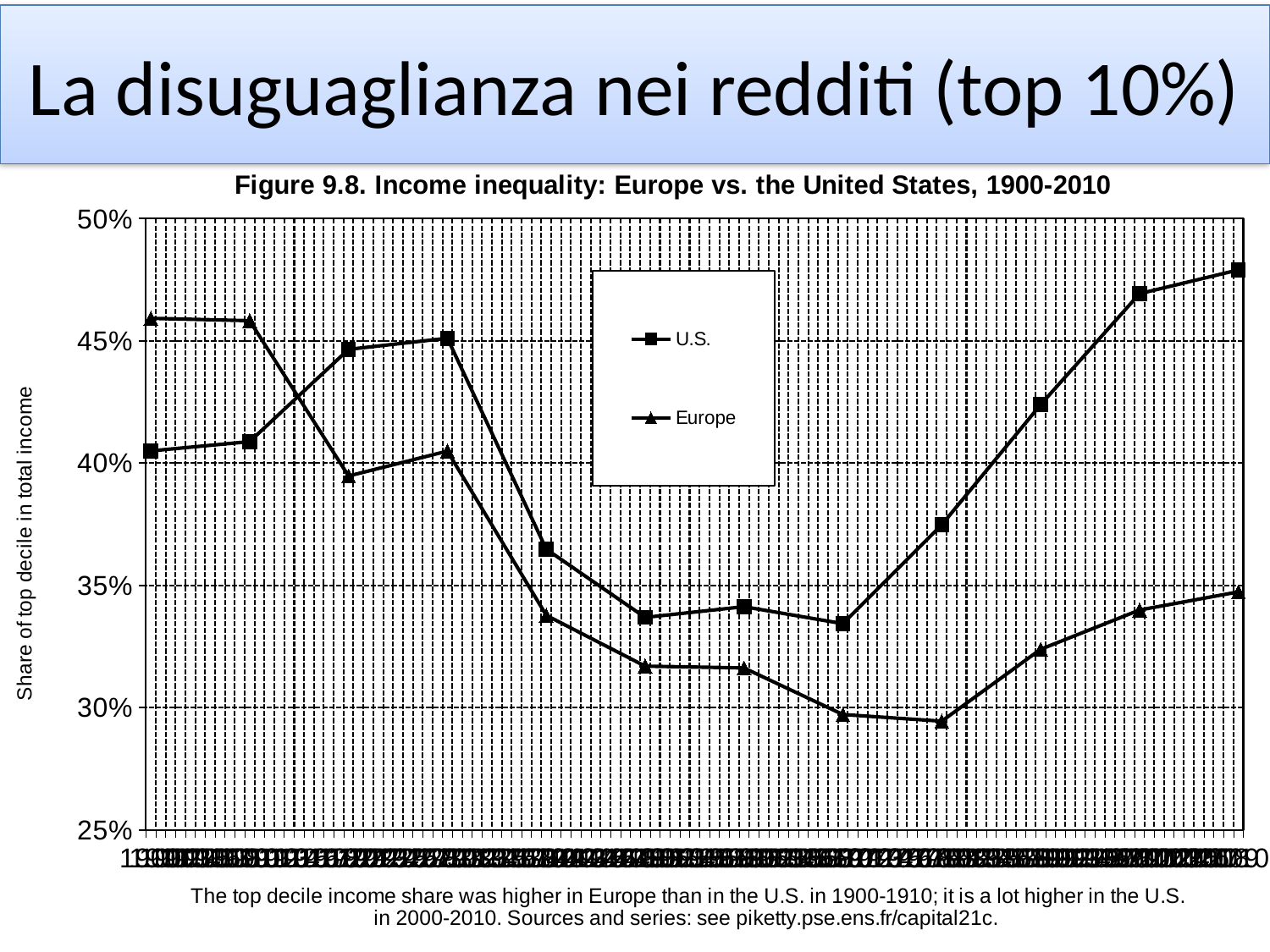
Which series contains the lowest point on the chart? Europe What are the two series named in the legend? U.S. and Europe How many series does the legend list? 2 Is the rightmost value of the U.S. series greater or less than 45%? greater How many data points are plotted for the U.S. series? 12 Over the right half of the chart, do the U.S. values rise or fall along the x axis? rise At the leftmost point of the chart, which series is higher, U.S. or Europe? Europe What is the title of the chart? Figure 9.8. Income inequality: Europe vs. the United States, 1900-2010 What kind of chart is shown on the slide? Line chart At the rightmost point of the chart, which series is higher, U.S. or Europe? U.S. Which series reaches the highest value anywhere on the chart? U.S.